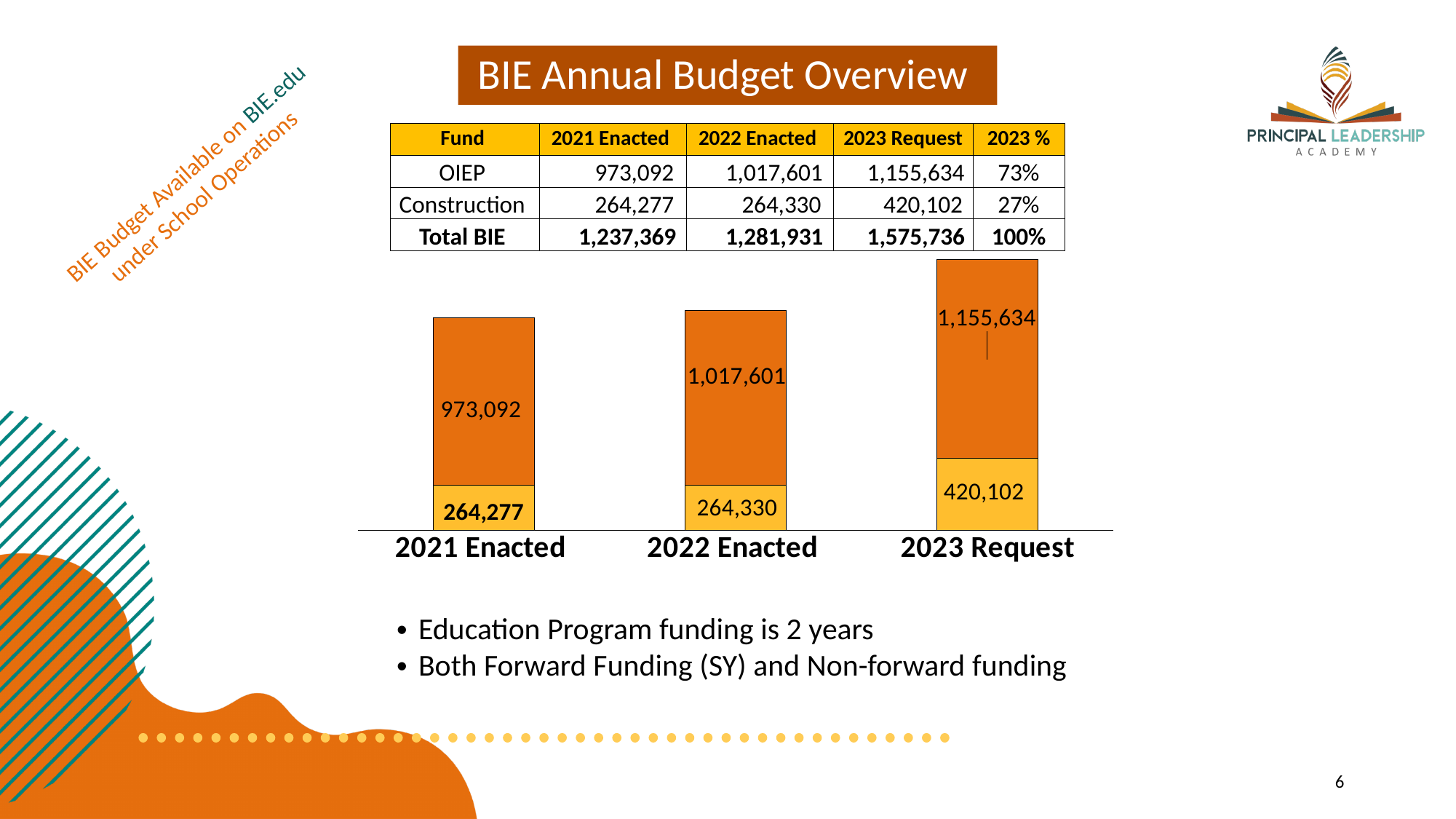
Which bar has the highest total? 2023 Request What is the value of the dark orange (OIEP) segment for 2023 Request? 1,155,634 Do the total bar heights rise or fall from 2021 Enacted to 2023 Request? Rise What is the value of the yellow (Construction) segment for 2022 Enacted? 264,330 What is the value of the yellow (Construction) segment for 2023 Request? 420,102 What kind of chart is shown on the slide? Stacked bar chart What is the difference between the OIEP values for 2023 Request and 2021 Enacted? 182,542 Which bar has the lowest total? 2021 Enacted Which is larger, the Construction value for 2023 Request or for 2022 Enacted? 2023 Request How many bars (categories) are shown on the x axis of the chart? 3 What is the total of the stacked bar for 2023 Request? 1,575,736 What is the value of the dark orange (OIEP) segment for 2021 Enacted? 973,092